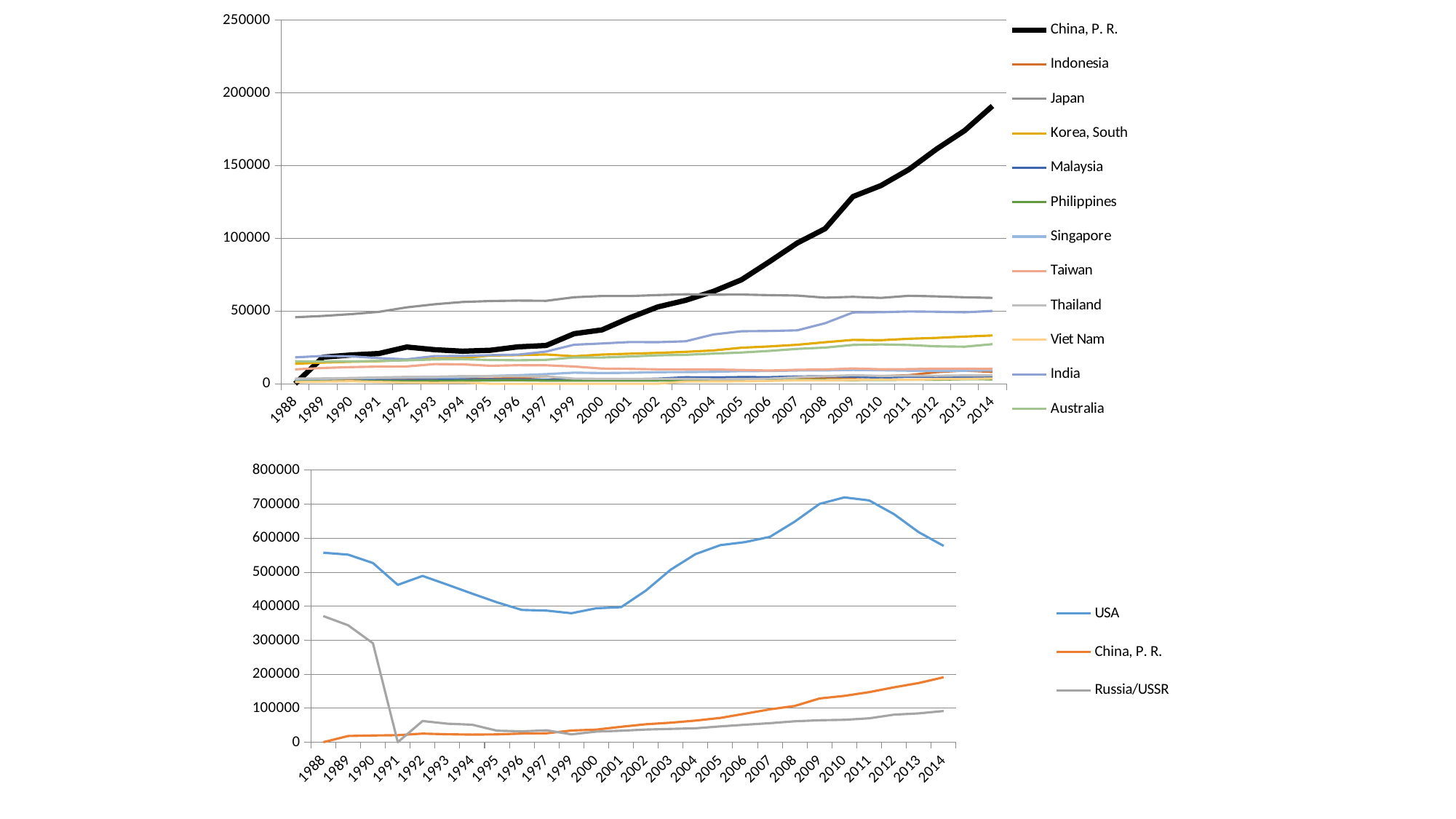
In the bottom chart, is the value for Russia/USSR in 1988 greater or less than 300000? greater In the bottom chart, is the value for USA in 2010 greater or less than 700000? greater How many years are shown on the x axis of the top chart? 26 In the top chart, is the value for China, P. R. in 2014 greater or less than 150000? greater In the top chart, does the China, P. R. line rise or fall from 1988 to 2014? rises What kind of chart is the top chart on the slide? line chart In the bottom chart, which series has the highest value in 1988? USA How many series does the legend of the bottom chart list? 3 In the top chart, which series has the highest value in 2014? China, P. R. In the bottom chart, which is larger in 2014, USA or China, P. R.? USA How many series does the legend of the top chart list? 12